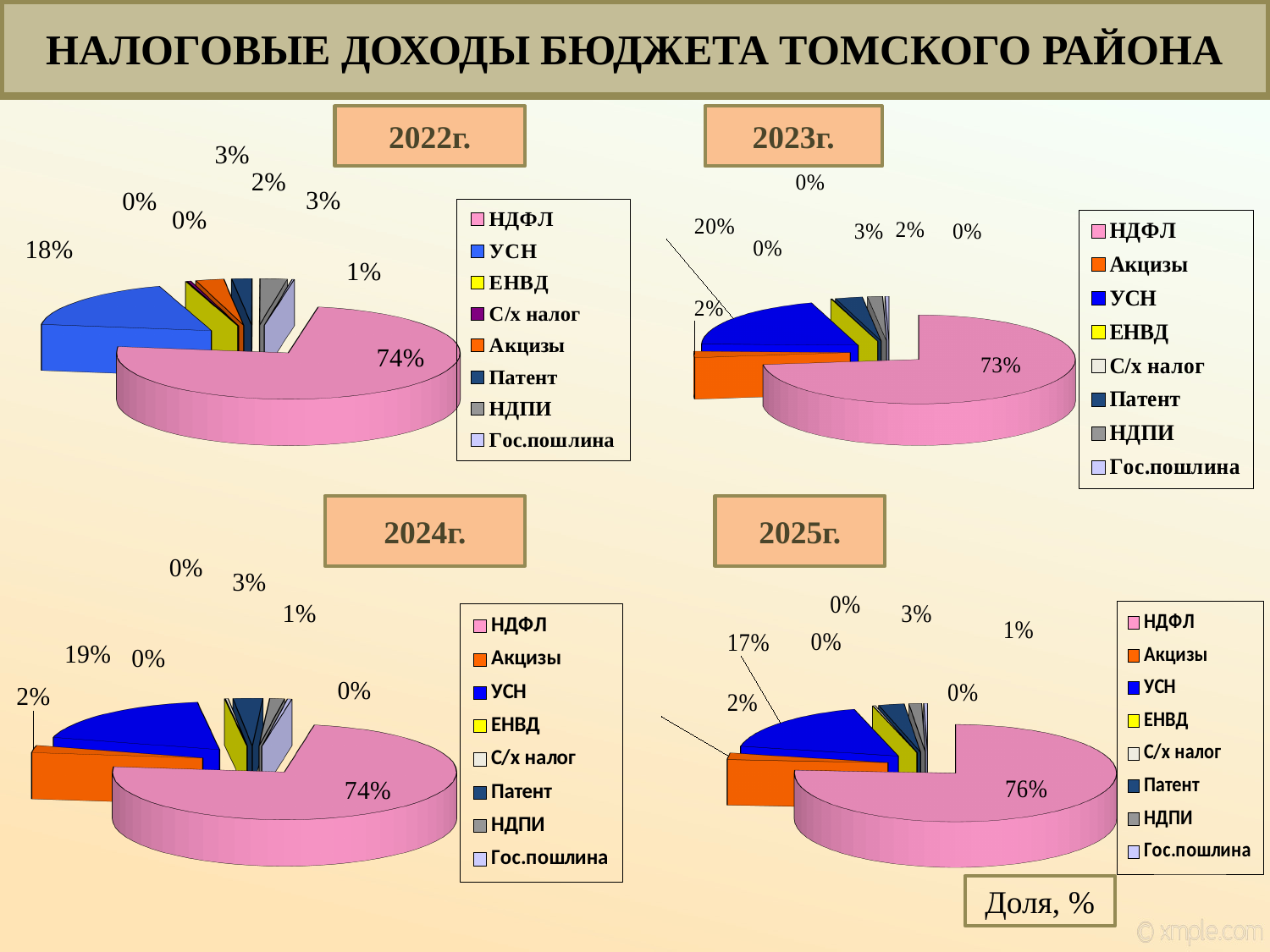
In the 2023г. pie chart, what share does НДФЛ have? 73% In the 2024г. pie chart, what is the value for Акцизы? 2% What type of chart is used for the 2024г. data? Pie chart In the 2025г. pie chart, what share does НДФЛ have? 76% In the 2022г. pie chart, what is the value for УСН? 18% How many entries does the legend of the 2023г. chart list? 8 In the 2025г. pie chart, what is the value for УСН? 17% In the 2024г. pie chart, what share does НДФЛ have? 74% Is the share of НДФЛ larger in the 2022г. chart or the 2025г. chart? 2025г. In the 2023г. pie chart, what is the value for УСН? 20% In the 2025г. pie chart, which category has the largest slice? НДФЛ